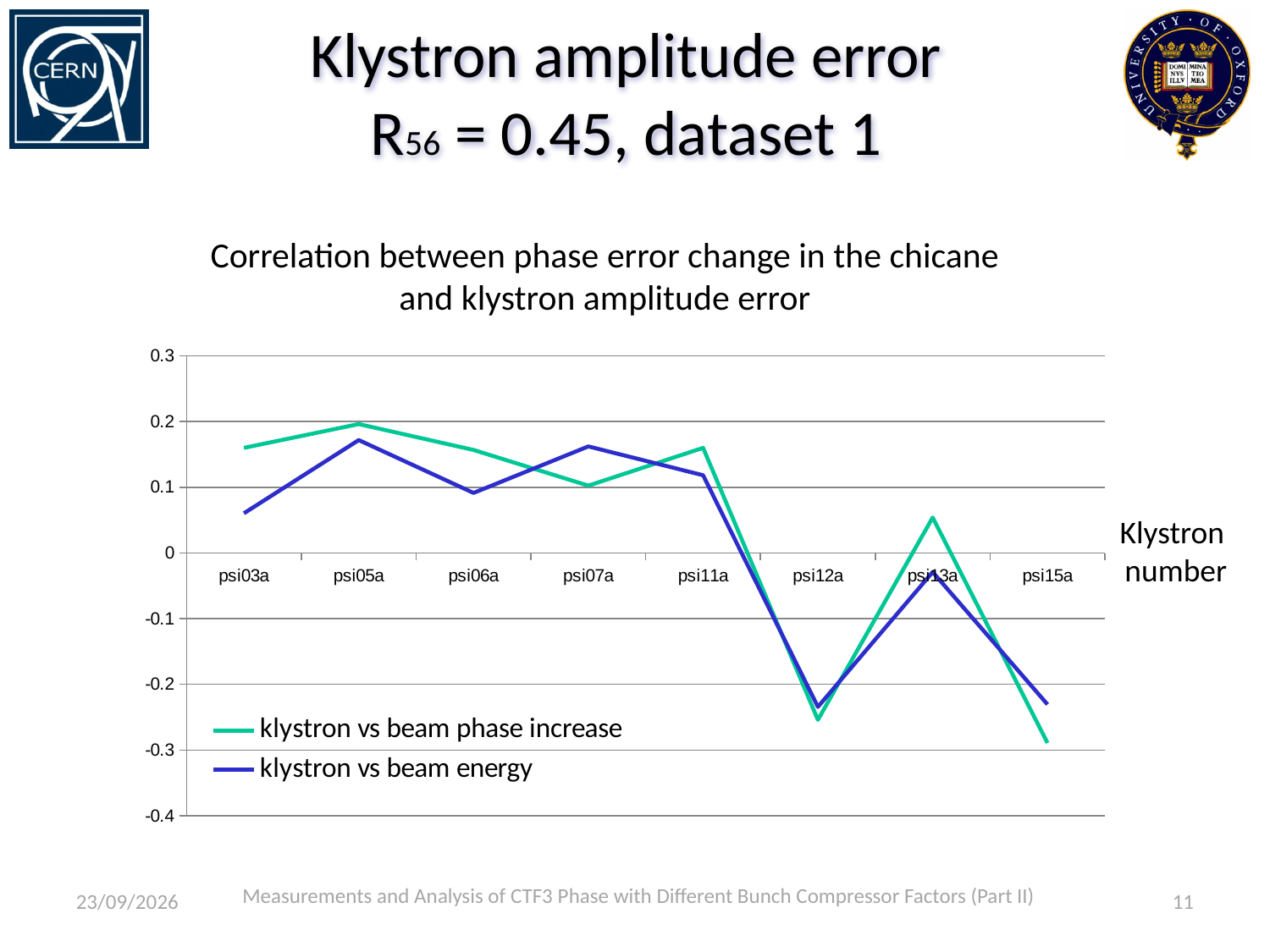
At psi03a, which series has the larger value: 'klystron vs beam phase increase' or 'klystron vs beam energy'? klystron vs beam phase increase Is the 'klystron vs beam phase increase' value for psi12a greater or less than -0.2? less How many series does the legend list? 2 What kind of chart is shown on the slide? line chart Is the 'klystron vs beam energy' value for psi03a greater or less than 0.1? less Is the 'klystron vs beam energy' value for psi13a greater or less than 0? less How many klystron categories are shown on the x axis? 8 Overall, do the values of the 'klystron vs beam energy' series rise or fall from psi03a to psi15a? fall Which klystron has the highest value for the 'klystron vs beam phase increase' series? psi05a What label is given to the x axis of the chart? Klystron number At psi07a, which series has the larger value: 'klystron vs beam phase increase' or 'klystron vs beam energy'? klystron vs beam energy